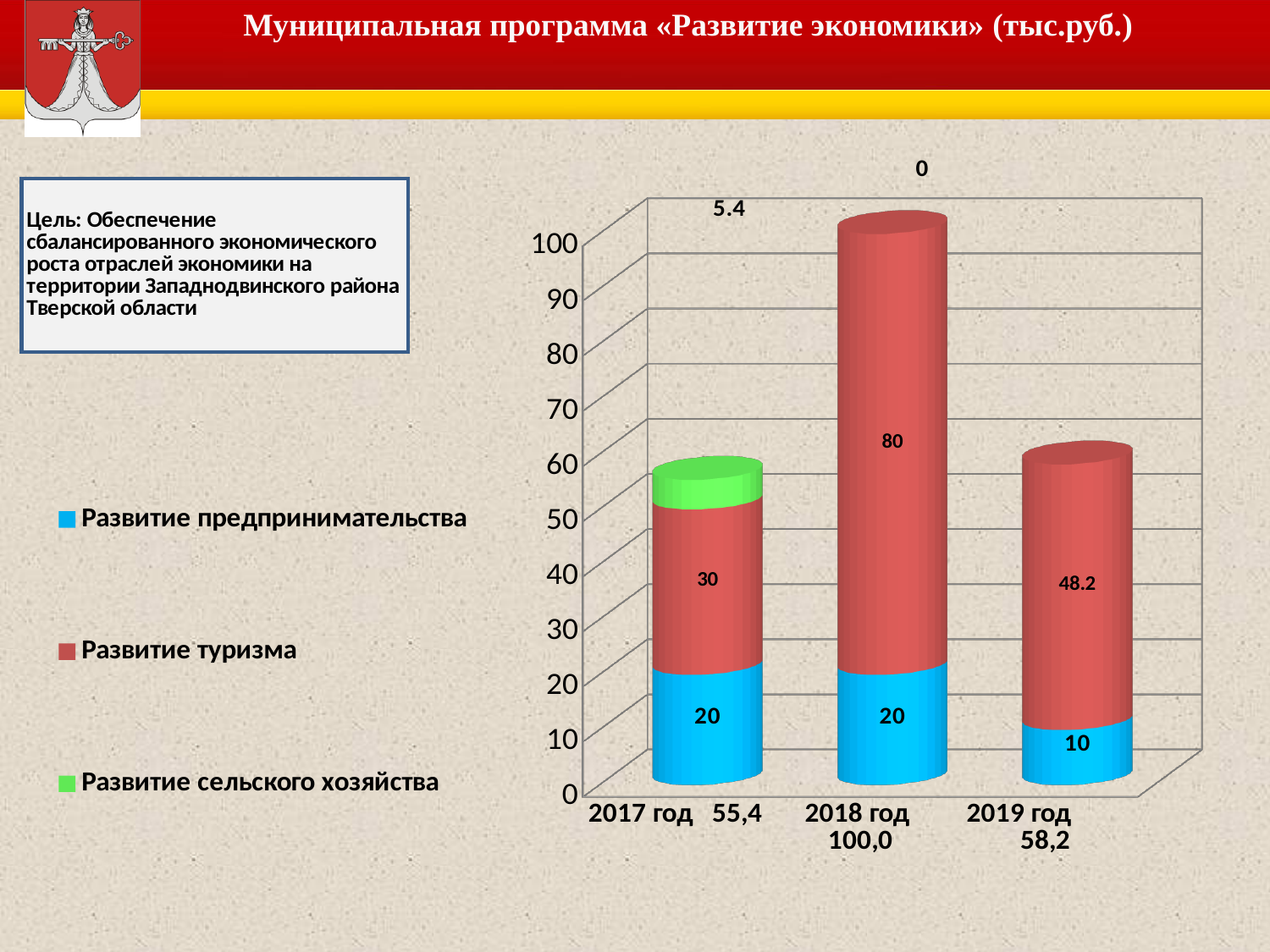
How many series does the legend list? 3 What is the value for Развитие сельского хозяйства in 2017 год? 5.4 Which year has the lowest value for Развитие предпринимательства? 2019 год What is the value for Развитие туризма in 2019 год? 48.2 How many categories (years) are shown on the x axis? 3 Which year has the highest value for Развитие туризма? 2018 год What is the difference between the Развитие туризма values for 2018 год and 2017 год? 50 What kind of chart is shown on the slide? bar chart What is the value for Развитие туризма in 2018 год? 80 What is the value for Развитие предпринимательства in 2019 год? 10 What is the total of the stacked bar for 2018 год, as printed in its category label? 100,0 Is the Развитие туризма value for 2019 год larger or smaller than the Развитие туризма value for 2017 год? larger